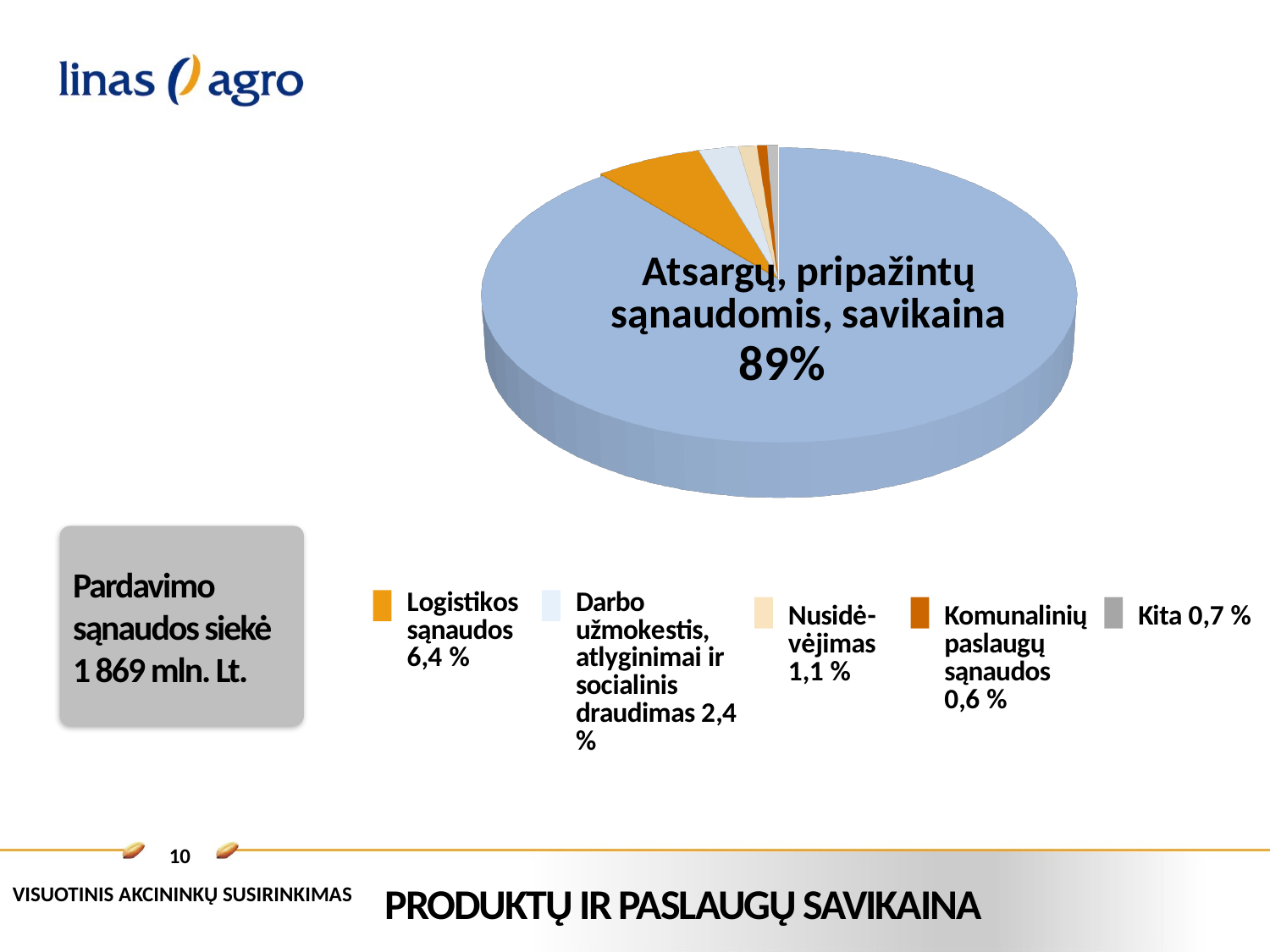
Which is larger, "Logistikos sąnaudos" or "Nusidėvėjimas"? Logistikos sąnaudos What is the value shown for "Darbo užmokestis, atlyginimai ir socialinis draudimas"? 2,4 % Which category has the largest slice of the pie? Atsargų, pripažintų sąnaudomis, savikaina How many slices does the pie chart have? 6 What is the value shown for "Nusidėvėjimas"? 1,1 % What is the value shown for "Komunalinių paslaugų sąnaudos"? 0,6 % What kind of chart is shown on the slide? pie chart What is the value shown for "Logistikos sąnaudos"? 6,4 % What share of the pie does "Atsargų, pripažintų sąnaudomis, savikaina" represent? 89% What is the value shown for "Kita"? 0,7 % What is the difference between "Logistikos sąnaudos" and "Darbo užmokestis, atlyginimai ir socialinis draudimas"? 4,0 % Which category has the smallest slice of the pie? Komunalinių paslaugų sąnaudos